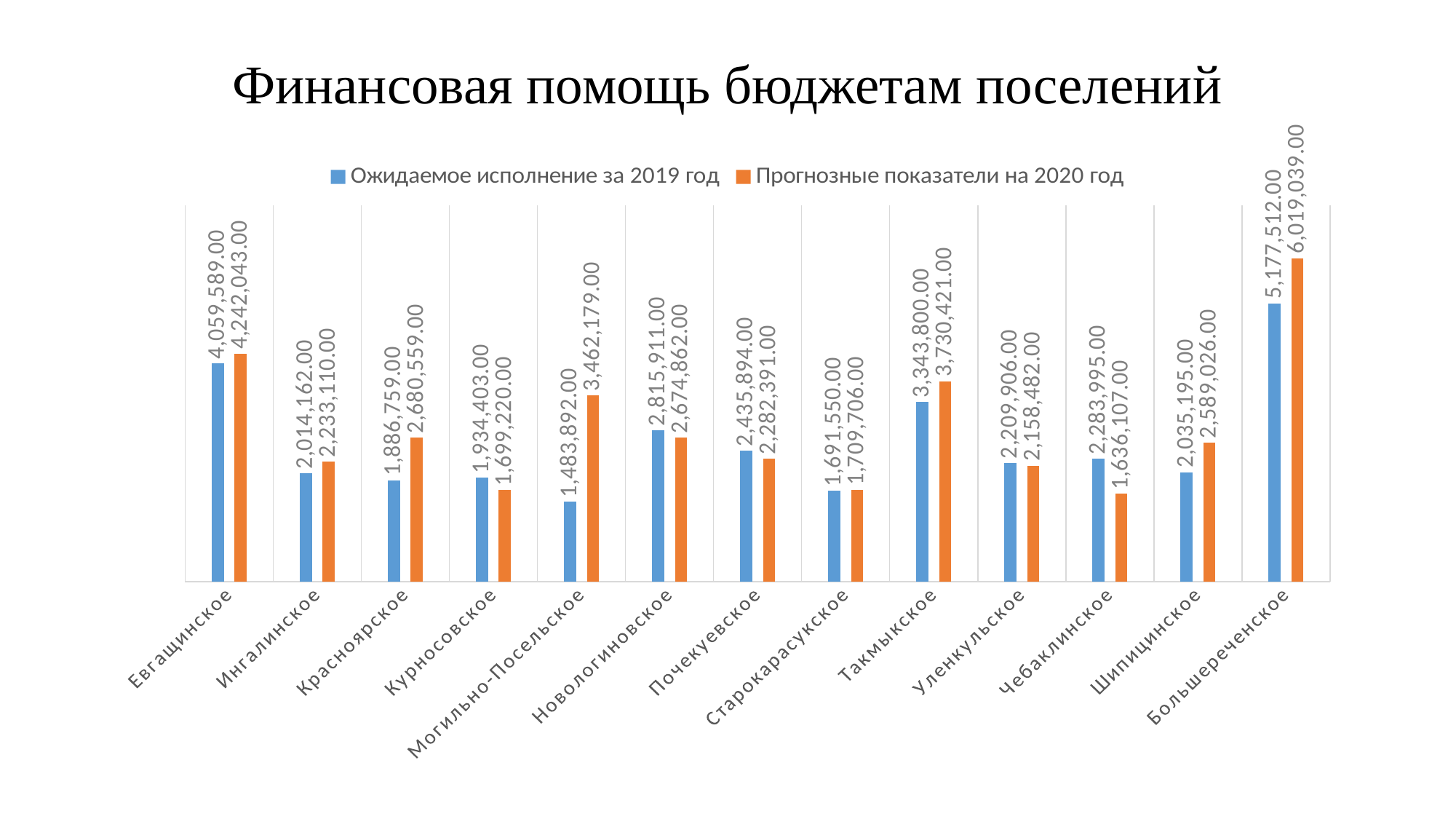
How many categories (settlements) are shown on the x axis? 13 How many series does the legend list? 2 What is the value of Прогнозные показатели на 2020 год for Шипицинское? 2,589,026.00 What is the value of Ожидаемое исполнение за 2019 год for Евгащинское? 4,059,589.00 What type of chart is shown on the slide? Bar chart Which category has the lowest value for Прогнозные показатели на 2020 год? Чебаклинское What is the difference between the 2020 and 2019 values for Могильно-Посельское? 1,978,287.00 What is the value of Прогнозные показатели на 2020 год for Могильно-Посельское? 3,462,179.00 For Чебаклинское, which is larger: the 2019 value or the 2020 value? 2019 value Which category has the lowest value for Ожидаемое исполнение за 2019 год? Могильно-Посельское Which category has the highest value for Ожидаемое исполнение за 2019 год? Большереченское What is the difference between the 2020 and 2019 values for Большереченское? 841,527.00